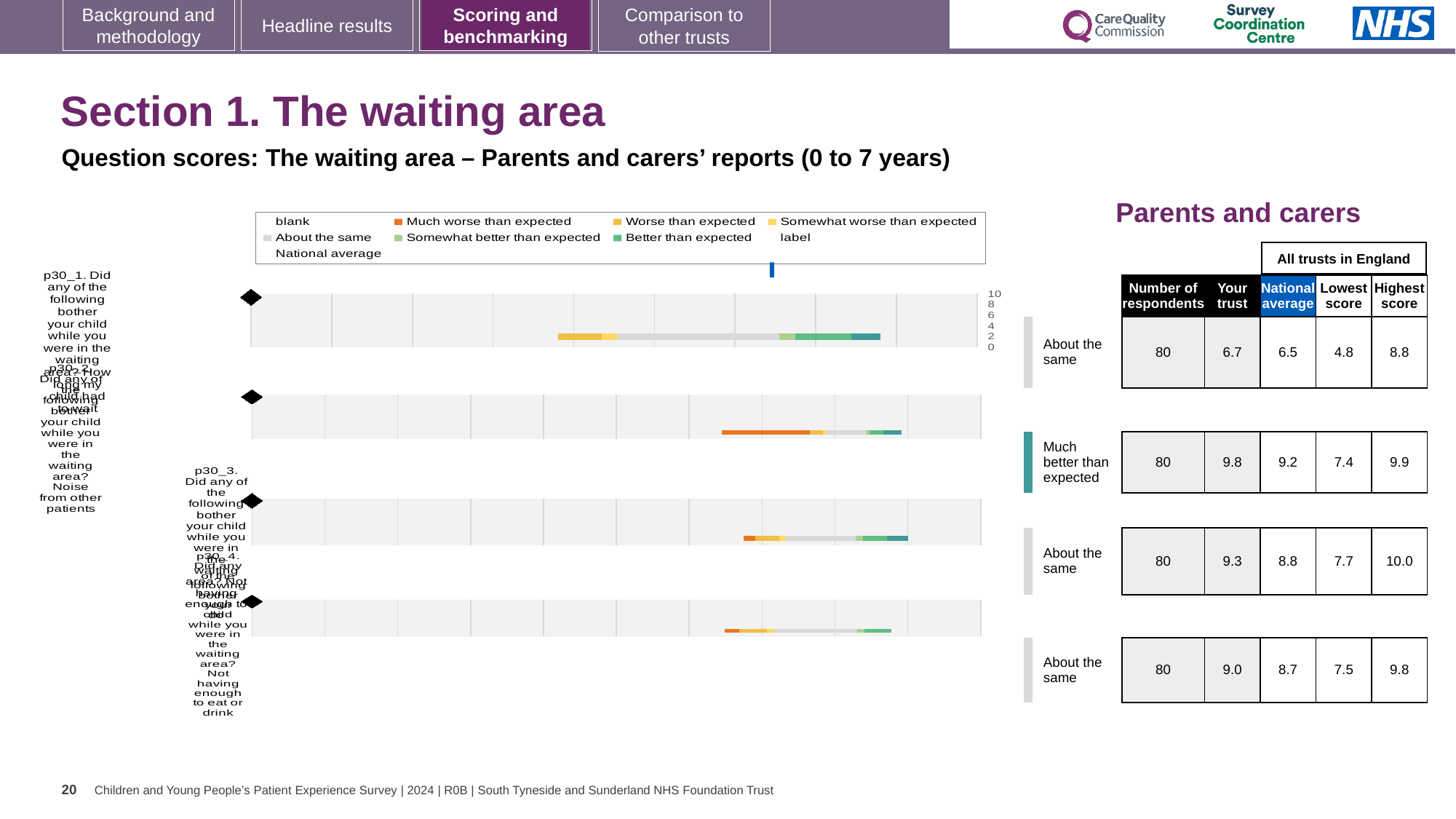
What is the difference between the 'Your trust' score and the national average for the second question? 0.6 What is the highest score across all trusts in England for the third question? 10.0 What is the lowest score across all trusts in England for the second question? 7.4 How many respondents answered the fourth question (not having enough to eat or drink)? 80 How many questions (bars) are plotted in the chart? 4 Which question has the highest 'Your trust' score? The second question (9.8) Which rating is shown for the second question: 'About the same' or 'Much better than expected'? Much better than expected What is the national average score for the first question (noise from other patients)? 6.5 Which question has the lowest 'Your trust' score? The first question, noise from other patients (6.7) What is the 'Your trust' score for the first question (noise from other patients)? 6.7 What kind of chart is used to show the question scores on this slide? bar chart How many entries does the chart legend list? 9